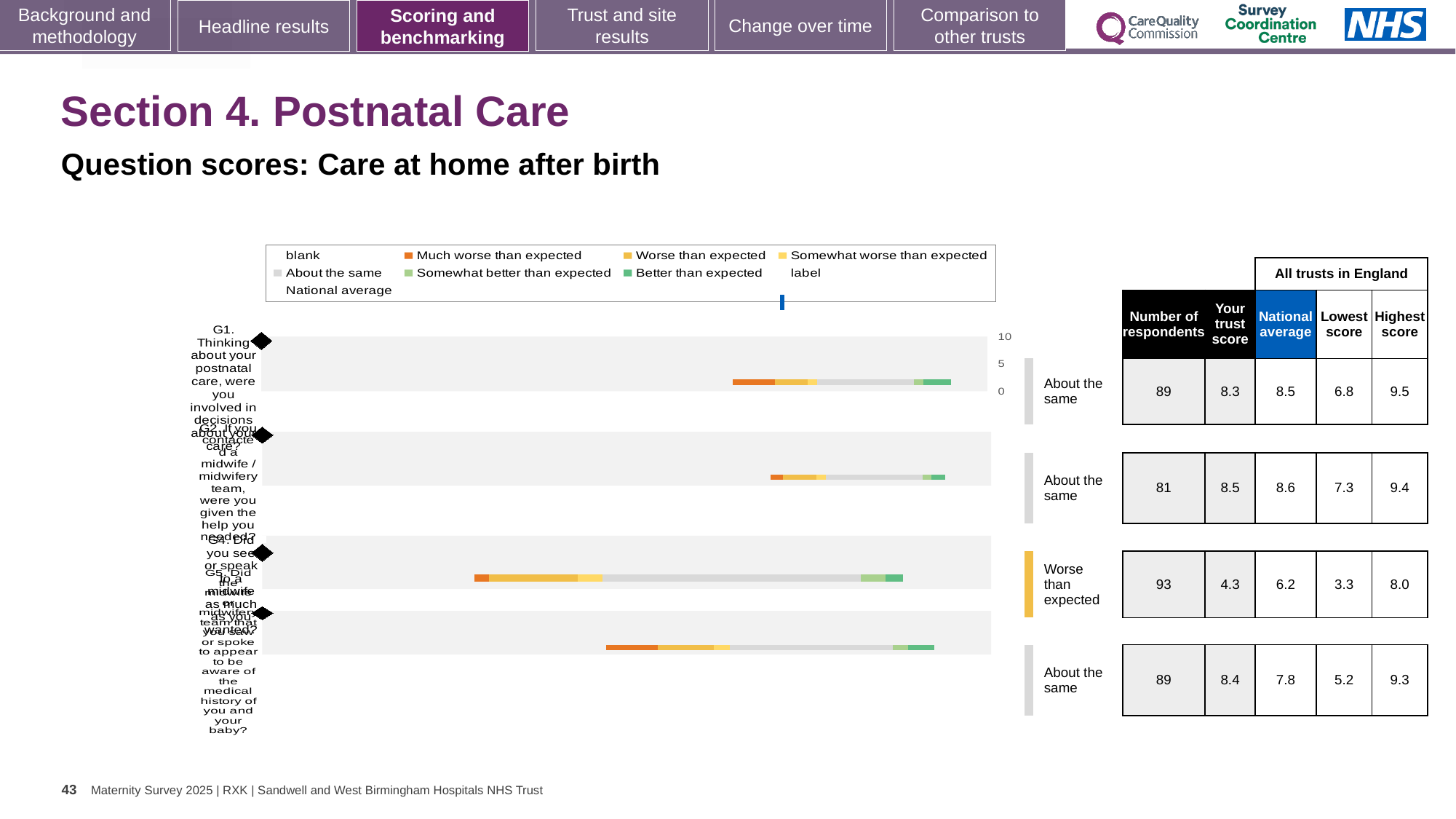
In the table next to the chart, what is the national average for the second row (G2)? 8.6 For the third row, which is larger: the trust score or the national average? the national average In the table next to the chart, what is the highest score for the fourth row? 9.3 Which legend entry is shown with an orange colour? Much worse than expected In the table next to the chart, what is the trust score for the first row (G1)? 8.3 In the table next to the chart, what is the number of respondents for the first row (G1)? 89 What is the difference between the national average and the trust score for the first row (G1)? 0.2 How many question bars are plotted in the chart? 4 Which row in the table has the highest trust score? the second row (8.5) What kind of chart is shown on the slide? bar chart In the table next to the chart, what is the lowest score for the third row? 3.3 Which row in the table has the lowest trust score? the third row (4.3)